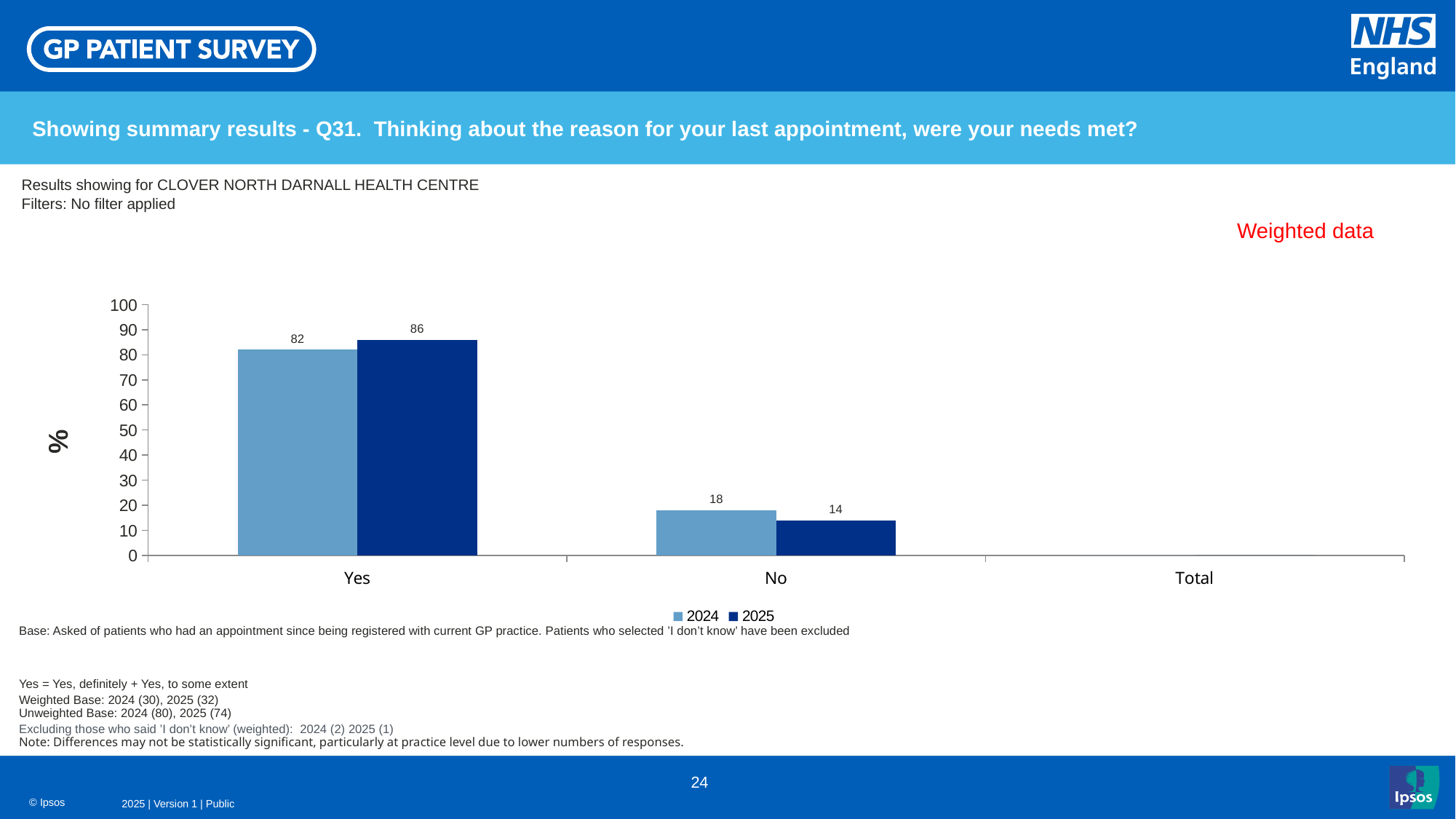
What is the difference between the 2025 and 2024 values for Yes? 4 What is the difference between the 2024 and 2025 values for No? 4 What is the value for Yes in 2024? 82 Which category has the highest value in 2025? Yes Which category has the lowest value in 2024? No What label is shown on the vertical axis? % What kind of chart is shown on the slide? Bar chart How many series does the legend list? 2 What is the value for Yes in 2025? 86 What is the value for No in 2025? 14 Which is larger for No: the 2024 value or the 2025 value? 2024 What is the value for No in 2024? 18